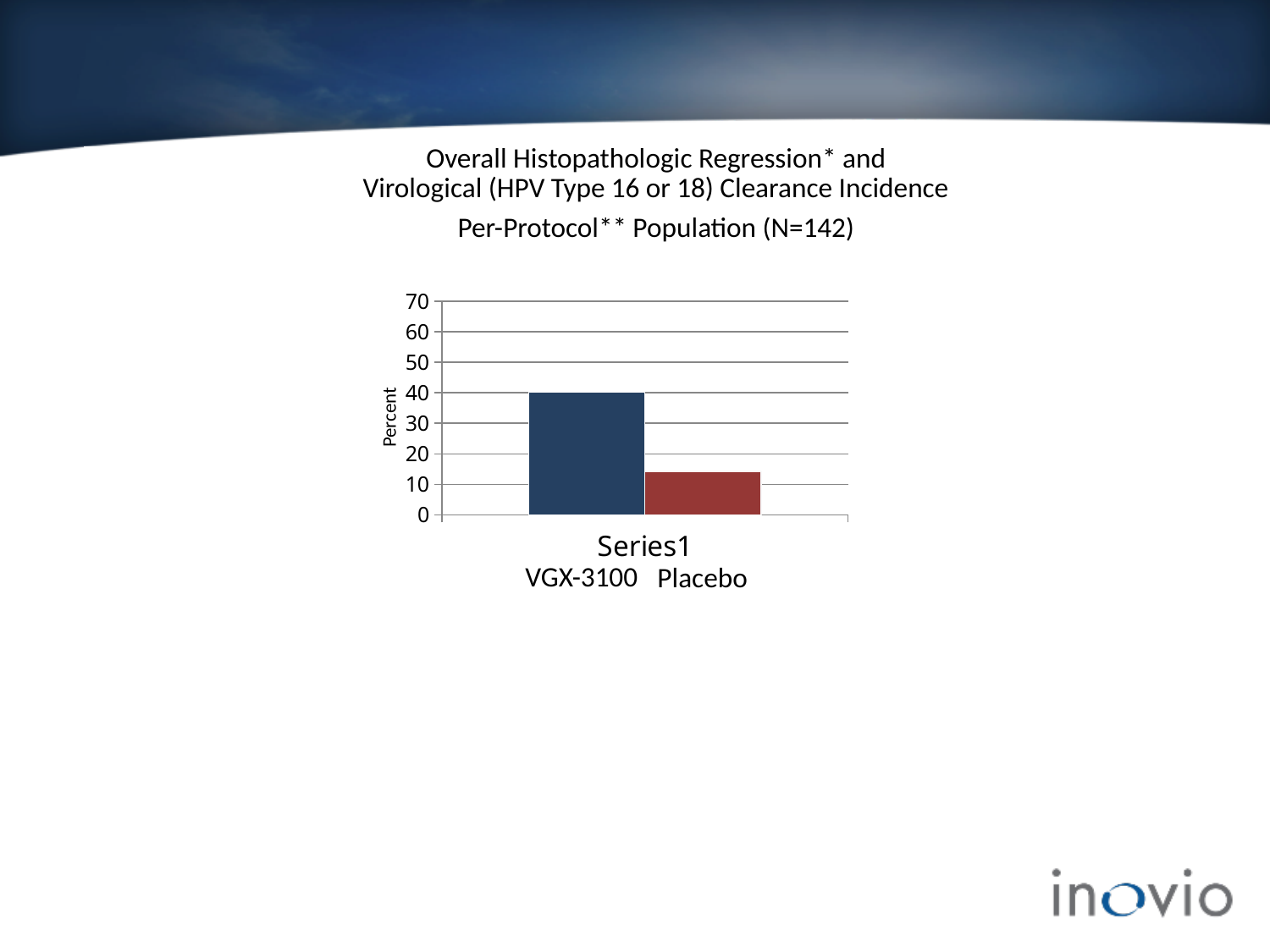
What is the label on the vertical axis of the chart? Percent What kind of chart is shown on the slide? bar chart Which group has the highest value in the chart? VGX-3100 What is the highest value shown on the vertical axis of the chart? 70 Is the value for Placebo greater or less than 10? greater Which is larger, the value for VGX-3100 or the value for Placebo? VGX-3100 Is the value for Placebo greater or less than 20? less Is the value for VGX-3100 greater or less than 30? greater Which group has the lowest value in the chart? Placebo How many bars are plotted in the chart? 2